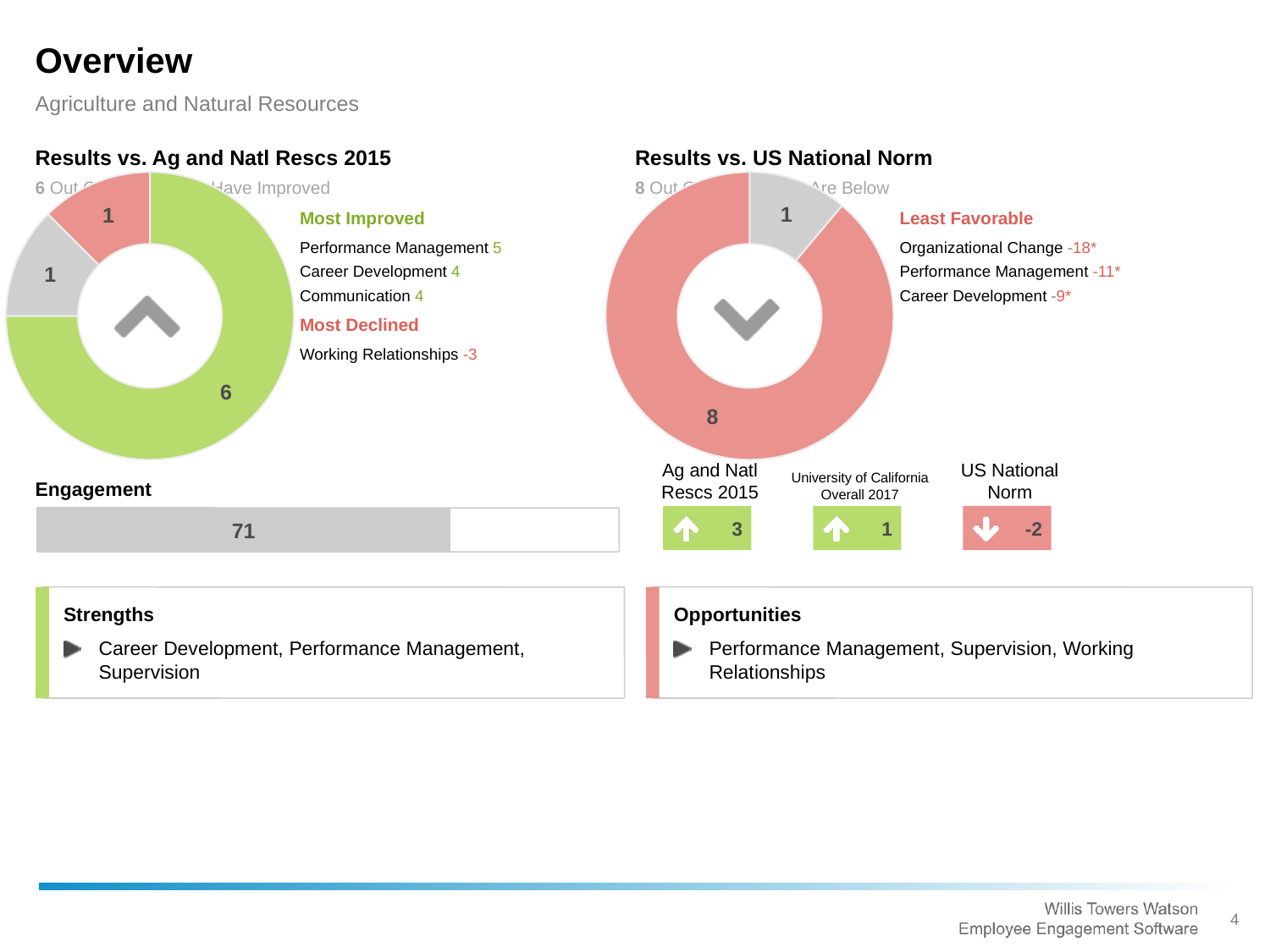
What is the title of the chart on the right side of the slide? Results vs. US National Norm In the 'Results vs. US National Norm' chart, what is the value of the largest slice? 8 In the 'Results vs. Ag and Natl Rescs 2015' chart, which is larger, the green slice or the red slice? green slice In the 'Results vs. Ag and Natl Rescs 2015' chart, what is the value of the largest slice? 6 In the 'Results vs. Ag and Natl Rescs 2015' chart, what is the total of all slice values? 8 What value is shown on the Engagement bar? 71 In the 'Results vs. Ag and Natl Rescs 2015' chart, what share of the total does the green slice (6) represent? 75% In the 'Results vs. US National Norm' chart, how many slices are there? 2 What kind of chart is the 'Results vs. Ag and Natl Rescs 2015' chart? doughnut chart In the 'Results vs. US National Norm' chart, what is the total of all slice values? 9 In the 'Results vs. Ag and Natl Rescs 2015' chart, how many slices are there? 3 In the 'Results vs. US National Norm' chart, what is the difference between the red slice (8) and the grey slice (1)? 7